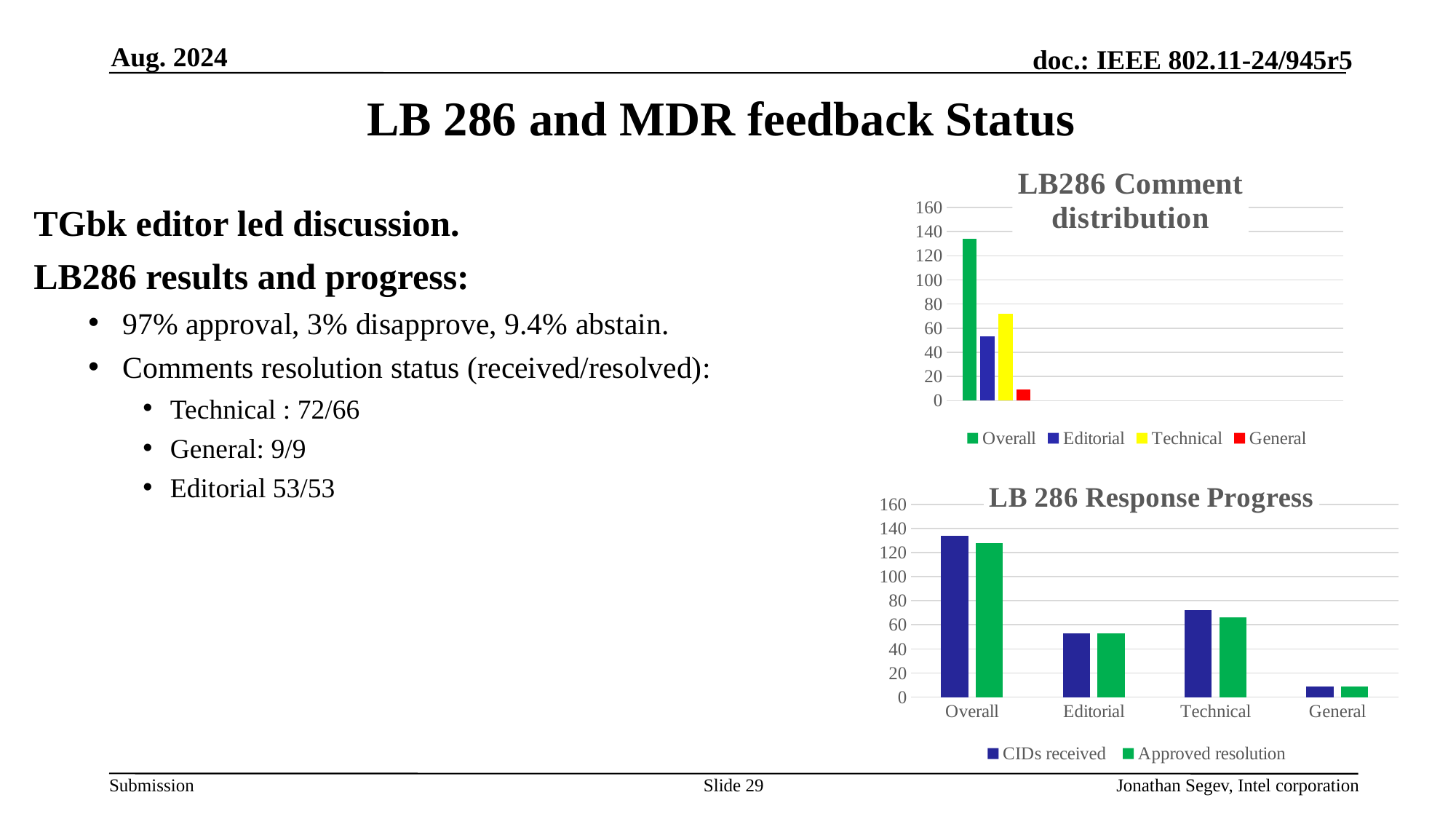
In the 'LB286 Comment distribution' chart, is the value for Overall greater or less than 120? greater In the 'LB 286 Response Progress' chart, which colour represents the 'Approved resolution' series? green In the 'LB 286 Response Progress' chart, how many series does the legend list? 2 In the 'LB 286 Response Progress' chart, which category has the lowest CIDs received? General In the 'LB286 Comment distribution' chart, which series has the tallest bar? Overall In the 'LB286 Comment distribution' chart, is the value for Technical greater or less than 60? greater In the 'LB 286 Response Progress' chart, how many categories are shown on the x axis? 4 In the 'LB286 Comment distribution' chart, how many series does the legend list? 4 In the 'LB 286 Response Progress' chart, is the Approved resolution value for Technical greater or less than 60? greater In the 'LB286 Comment distribution' chart, which is larger, Editorial or Technical? Technical In the 'LB286 Comment distribution' chart, which series has the shortest bar? General What kind of chart is the 'LB286 Comment distribution' chart? bar chart